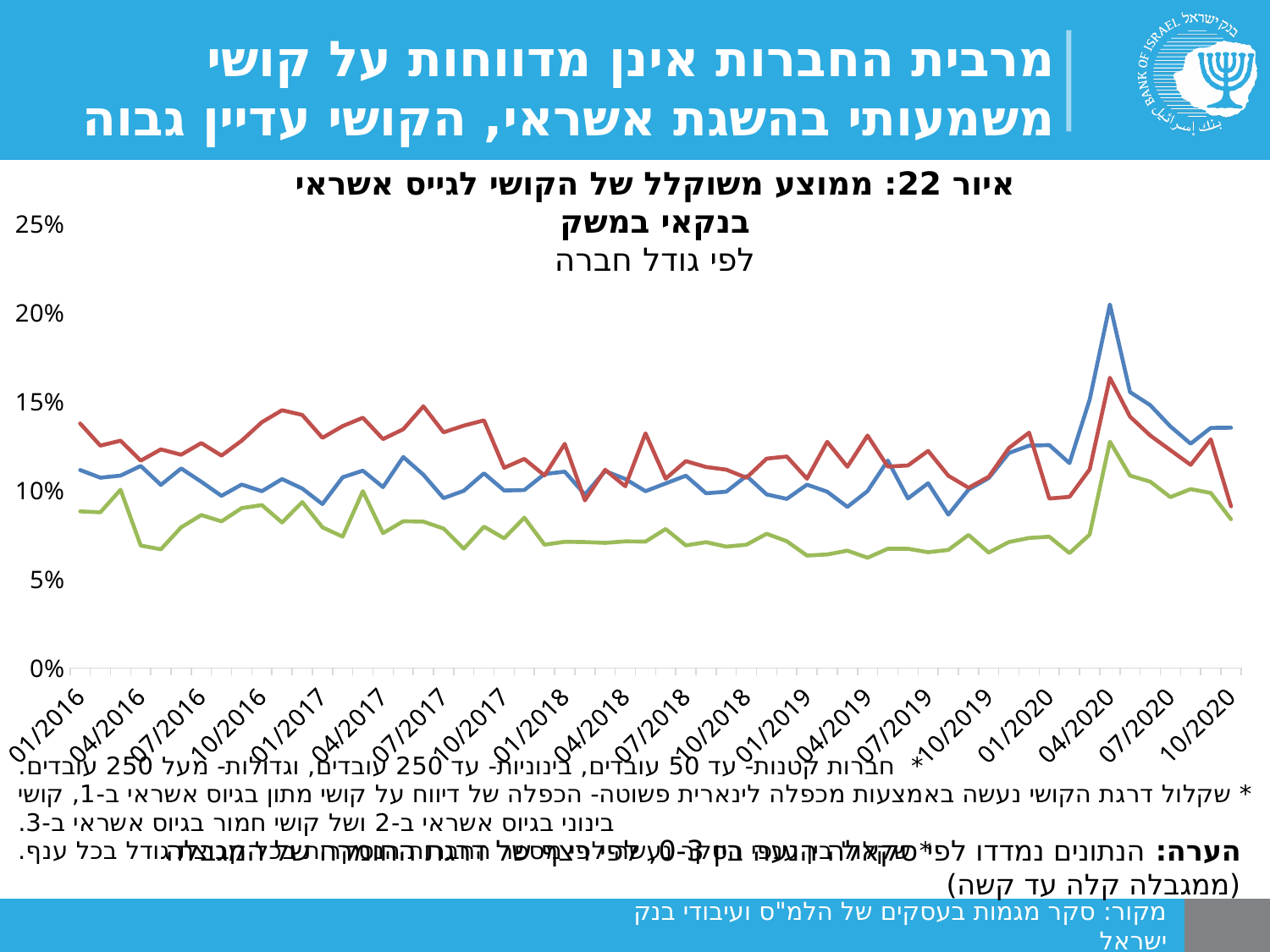
What is the highest value shown on the y axis? 25% Is the peak value of the blue line around 04/2020 greater or less than 15%? greater How many lines are plotted on the chart? 3 Is the value of the red line at 01/2016 greater or less than 10%? greater Which line reaches the highest value on the chart around 04/2020? the blue line Is the value of the green line at 01/2016 greater or less than 10%? less At 01/2016, which is larger: the red line or the blue line? the red line Does the blue line rise or fall between 10/2019 and 04/2020? rise What kind of chart is shown on the slide? line chart Which line is the lowest across almost the entire period? the green line How many date labels are shown on the x axis? 20